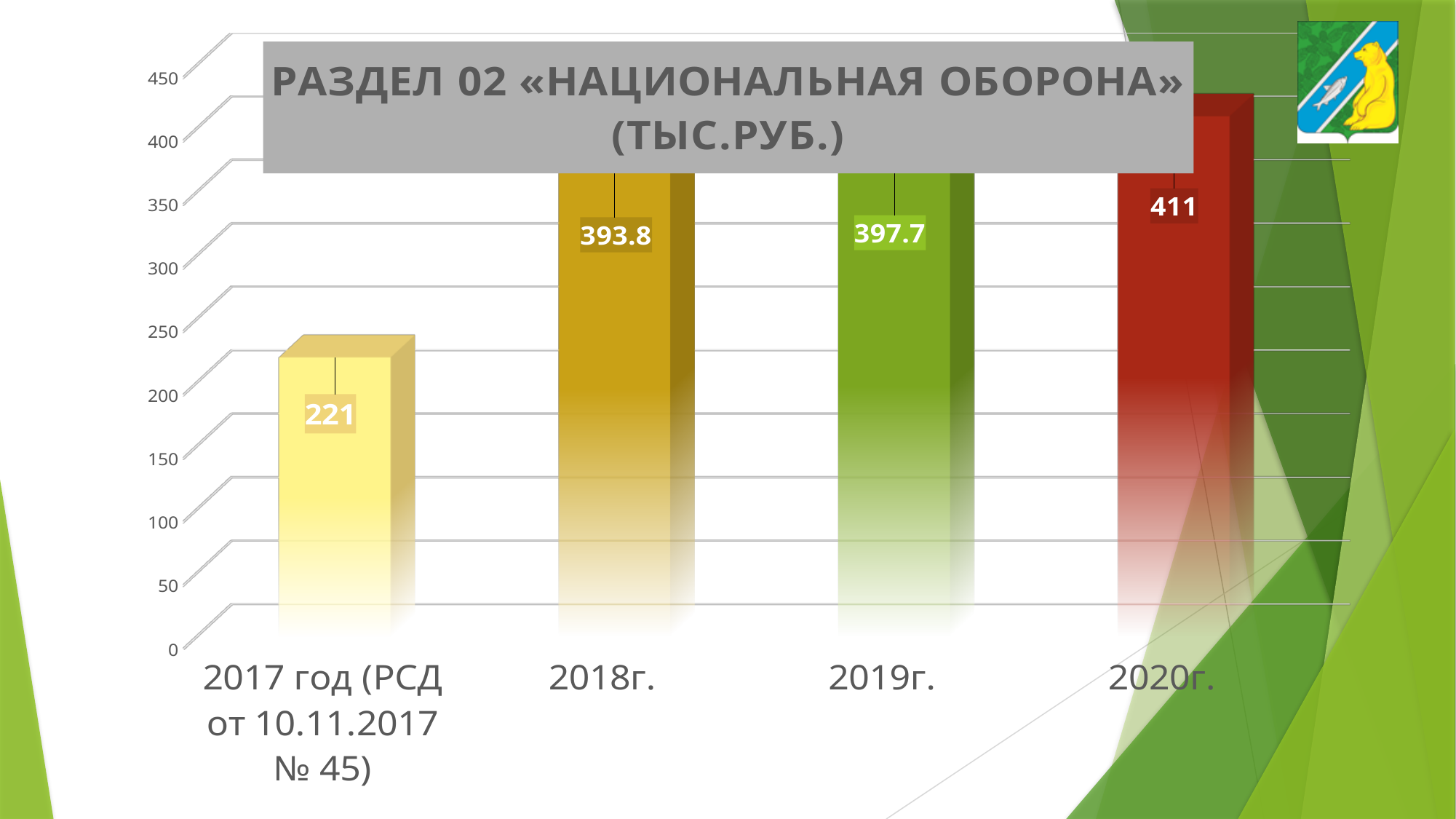
What kind of chart is shown on the slide? bar chart What is the difference between the values for 2019г. and 2018г.? 3.9 What is the value for 2017 год (РСД от 10.11.2017 № 45)? 221 What is the value for 2018г.? 393.8 Which is larger, the value for 2018г. or the value for 2020г.? 2020г. What is the value for 2019г.? 397.7 Which category has the highest value? 2020г. How many categories are shown on the x axis? 4 What is the value for 2020г.? 411 Which category has the lowest value? 2017 год (РСД от 10.11.2017 № 45) Do the values rise or fall from 2017 to 2020? rise What is the difference between the values for 2020г. and 2017 год (РСД от 10.11.2017 № 45)? 190